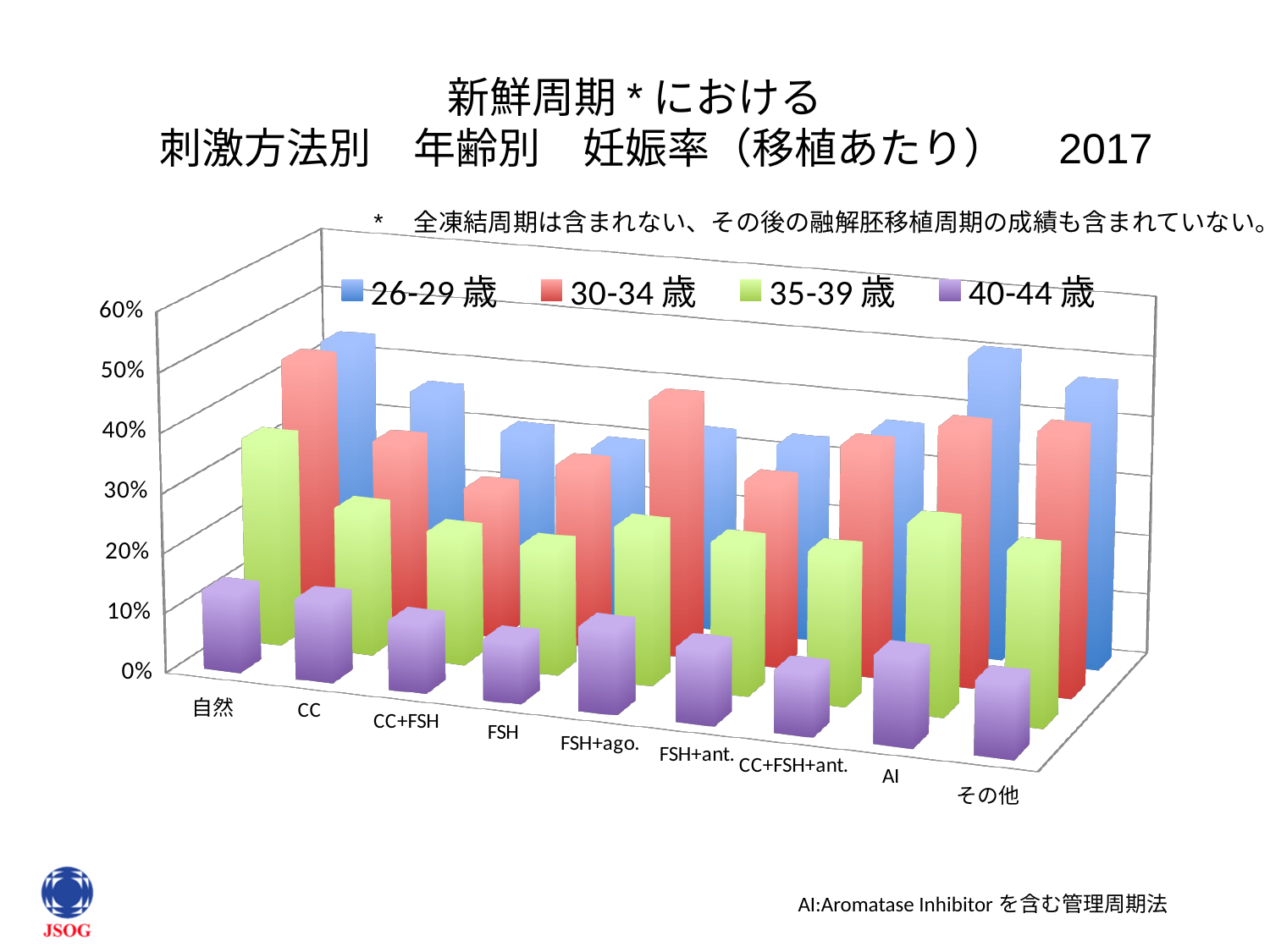
In the その他 category, which is larger: the value for 26-29 歳 or the value for 35-39 歳? 26-29 歳 How many stimulation-method categories are shown on the x axis? 9 Which age group does the purple series represent? 40-44 歳 In the 自然 category, which age group has the lowest value? 40-44 歳 Is the value for 35-39 歳 in the 自然 category greater or less than 30%? greater Is the value for 30-34 歳 in the 自然 category greater or less than 40%? greater Is the value for 40-44 歳 in the 自然 category greater or less than 20%? less In the 自然 category, which is larger: the value for 26-29 歳 or the value for 40-44 歳? 26-29 歳 What year is shown in the chart title? 2017 How many age-group series does the legend list? 4 What kind of chart is shown on the slide? bar chart